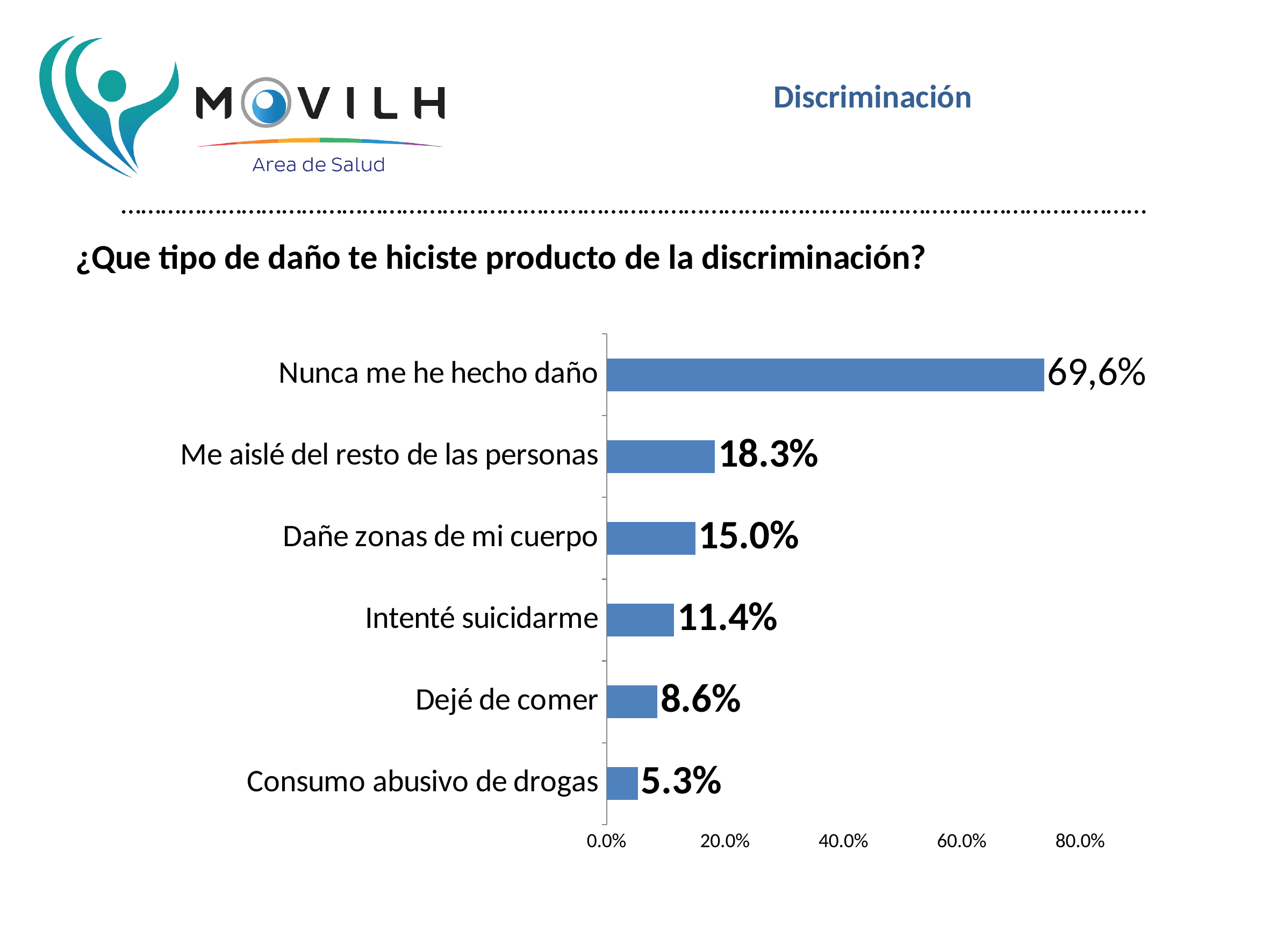
What is the value for "Me aislé del resto de las personas"? 18.3% Is the value for "Nunca me he hecho daño" greater or less than 60.0%? greater What kind of chart is shown on the slide? Bar chart What is the difference between "Me aislé del resto de las personas" and "Dañe zonas de mi cuerpo"? 3.3% Which category has the highest value? Nunca me he hecho daño How many categories are shown in the chart? 6 What is the value for "Consumo abusivo de drogas"? 5.3% Which is larger, "Dejé de comer" or "Intenté suicidarme"? Intenté suicidarme Which category has the lowest value? Consumo abusivo de drogas What is the value for "Intenté suicidarme"? 11.4% What is the value for "Nunca me he hecho daño"? 69,6% What question does the chart title ask? ¿Que tipo de daño te hiciste producto de la discriminación?